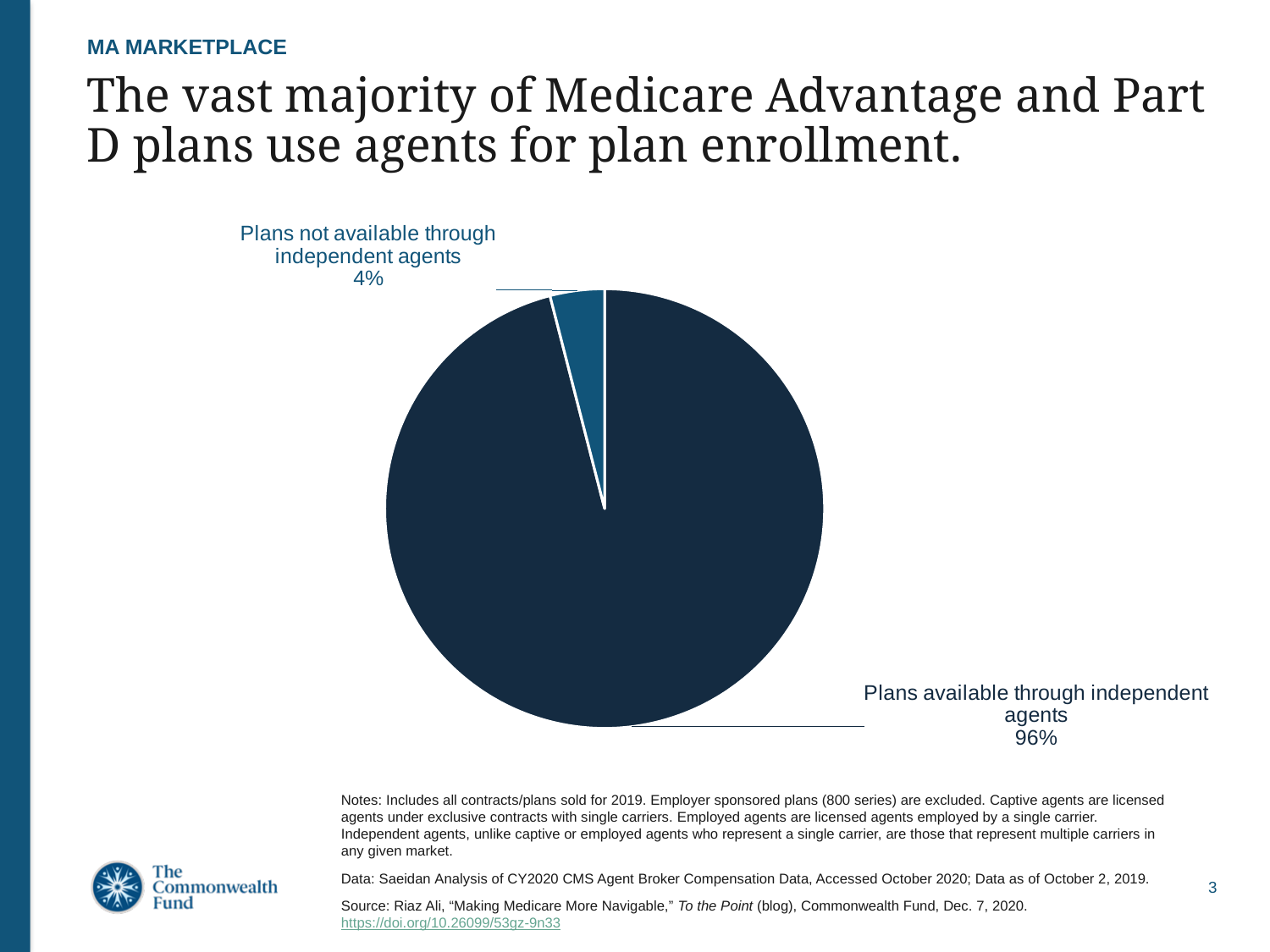
What share of plans are available through independent agents? 96% What share of plans are not available through independent agents? 4% What is the combined share of the two slices in the pie chart? 100% Which slice is shown in the lighter blue colour? Plans not available through independent agents What kind of chart is shown on the slide? pie chart What is the difference in percentage points between plans available through independent agents and plans not available through independent agents? 92 Which slice of the pie is the smallest? Plans not available through independent agents What is the section label shown above the slide title? MA MARKETPLACE Is the share of plans available through independent agents greater or less than 50%? greater Which is larger: the share of plans available through independent agents or the share not available through independent agents? Plans available through independent agents How many slices does the pie chart have? 2 Which slice of the pie is the largest? Plans available through independent agents